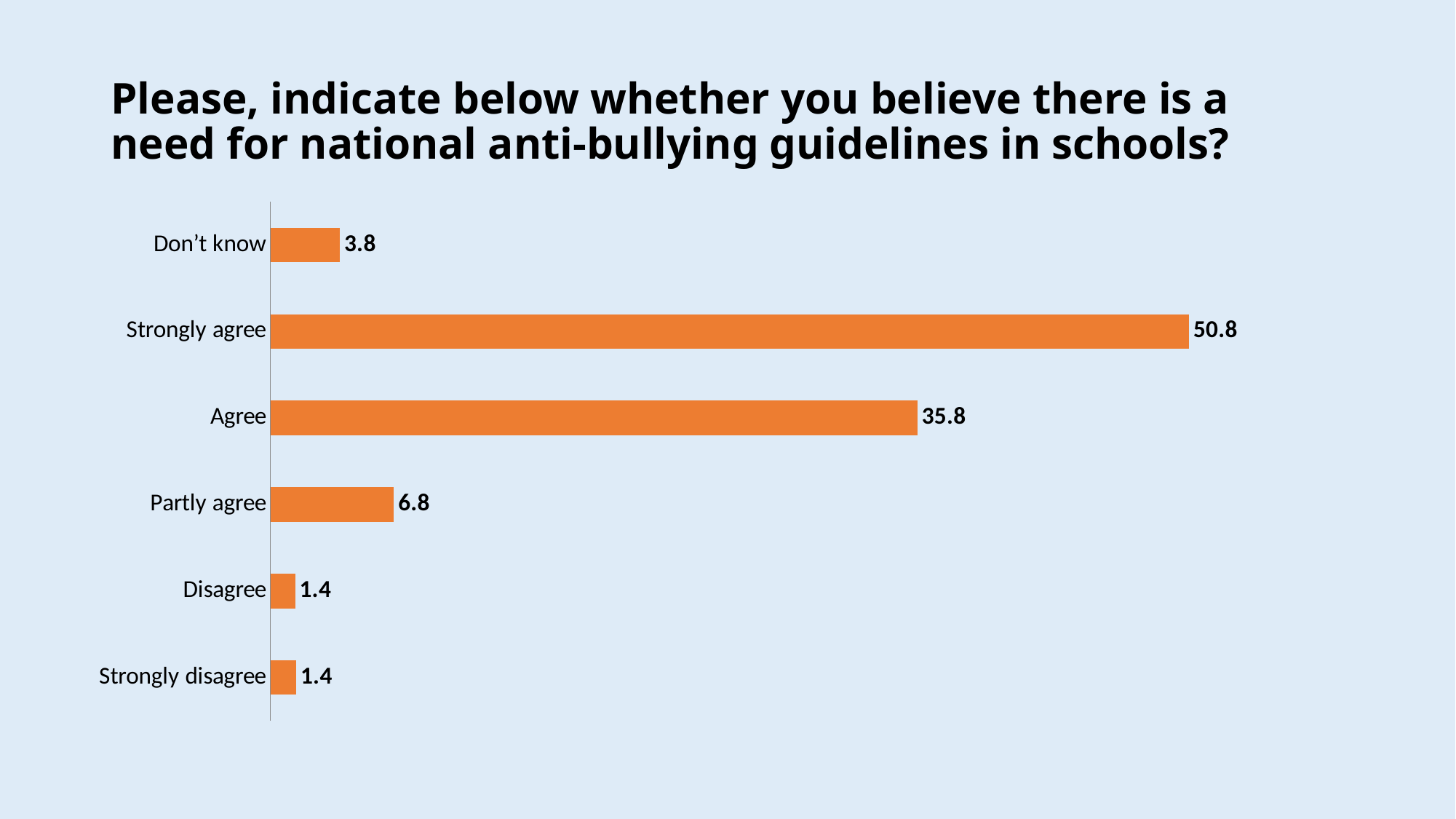
What is the value for Disagree? 1.4 What colour are the bars in the chart? Orange What is the difference between the values for Partly agree and Don't know? 3 What is the difference between the values for Strongly agree and Agree? 15 What is the value for Agree? 35.8 Which is larger, the value for Partly agree or the value for Don't know? Partly agree How many categories are shown in the chart? 6 What kind of chart is shown on the slide? Bar chart Which category has the highest value? Strongly agree What is the value for Don't know? 3.8 What is the value for Partly agree? 6.8 What is the value for Strongly agree? 50.8